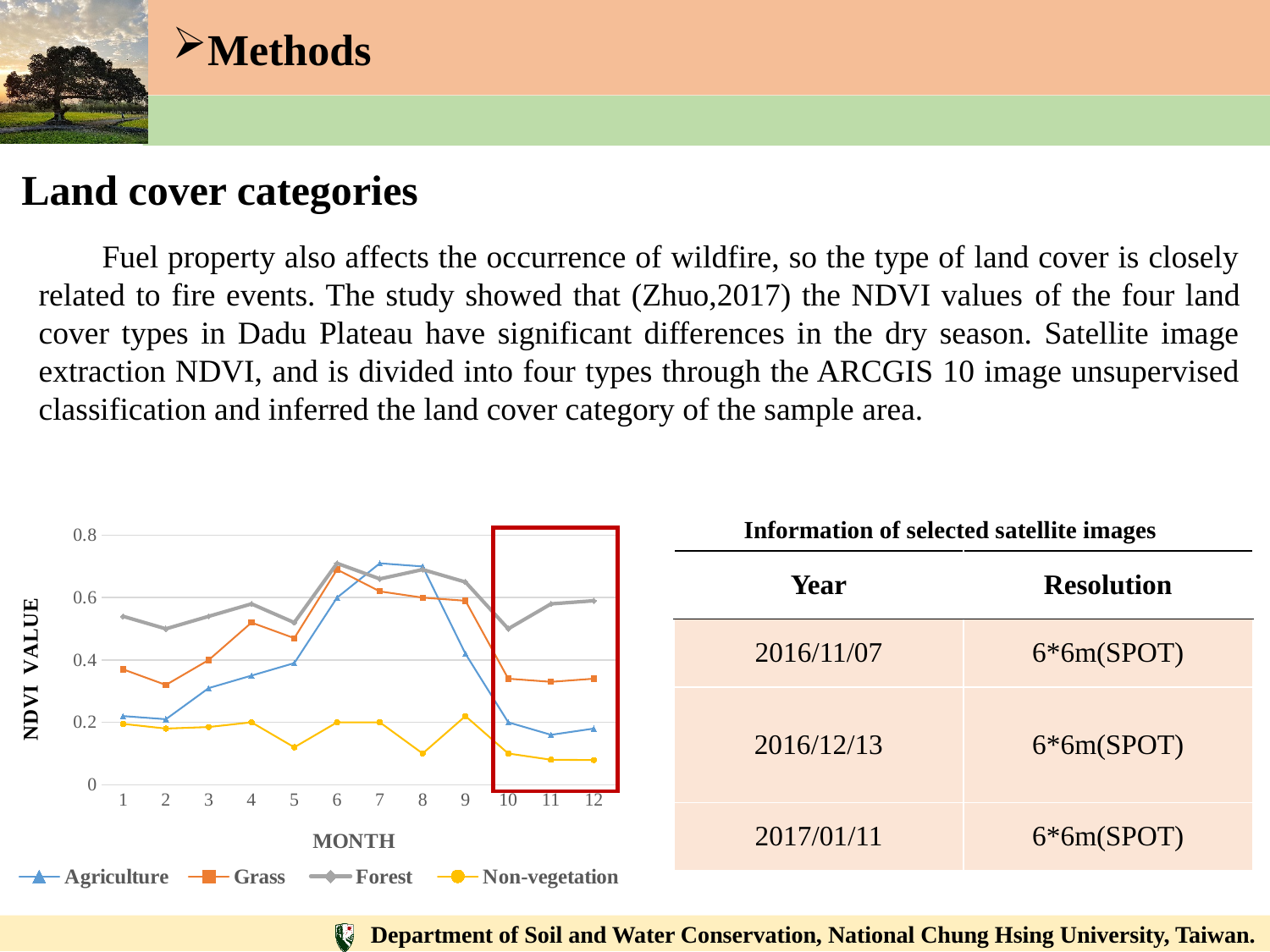
Is the Grass value at month 4 greater or less than 0.4? greater What is the title of the chart's y axis? NDVI VALUE What kind of chart is shown on the slide? line chart How many months are plotted along the x axis of the chart? 12 At month 12, which is larger: the Forest value or the Agriculture value? Forest Is the Non-vegetation value at month 11 greater or less than 0.2? less How many series does the chart legend list? 4 Is the Forest value at month 1 greater or less than 0.4? greater Which series has the lowest value at month 12? Non-vegetation Which series has the highest value at month 12? Forest Does the Agriculture series rise or fall from month 7 to month 11? fall